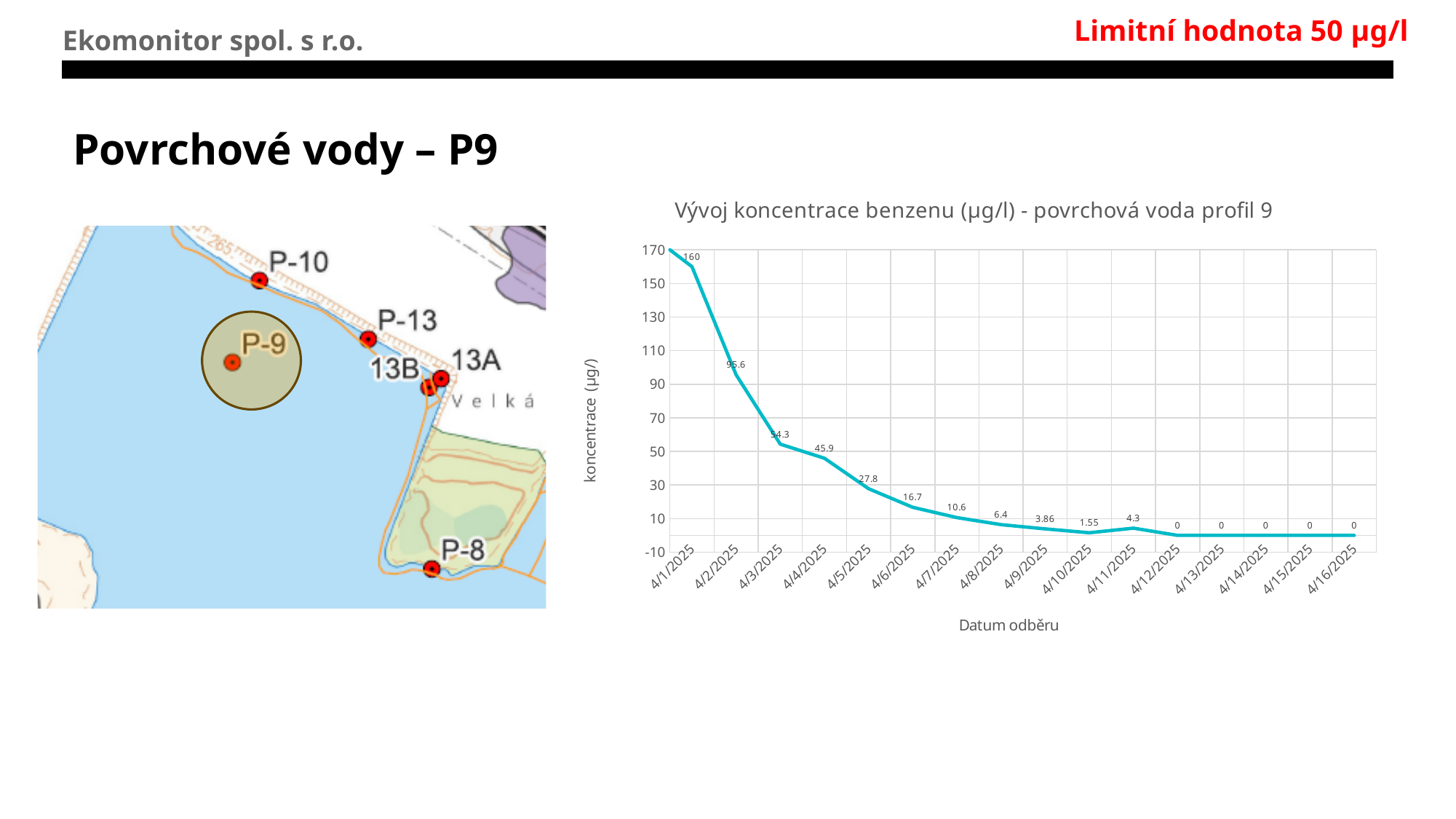
What value is shown for 4/9/2025? 3.86 Which date has the larger value, 4/10/2025 or 4/11/2025? 4/11/2025 What is the difference between the values on 4/3/2025 and 4/4/2025? 8.4 What kind of chart is shown on the slide? line chart What value is shown for 4/14/2025? 0 Is the value for 4/2/2025 greater or less than 50? greater What is the benzene concentration on 4/3/2025? 54.3 How many sampling dates are shown on the x axis? 16 What value is shown for 4/5/2025? 27.8 What is the benzene concentration on 4/11/2025? 4.3 Do the benzene concentrations rise or fall over the dates shown? fall What is the benzene concentration on 4/2/2025? 95.6